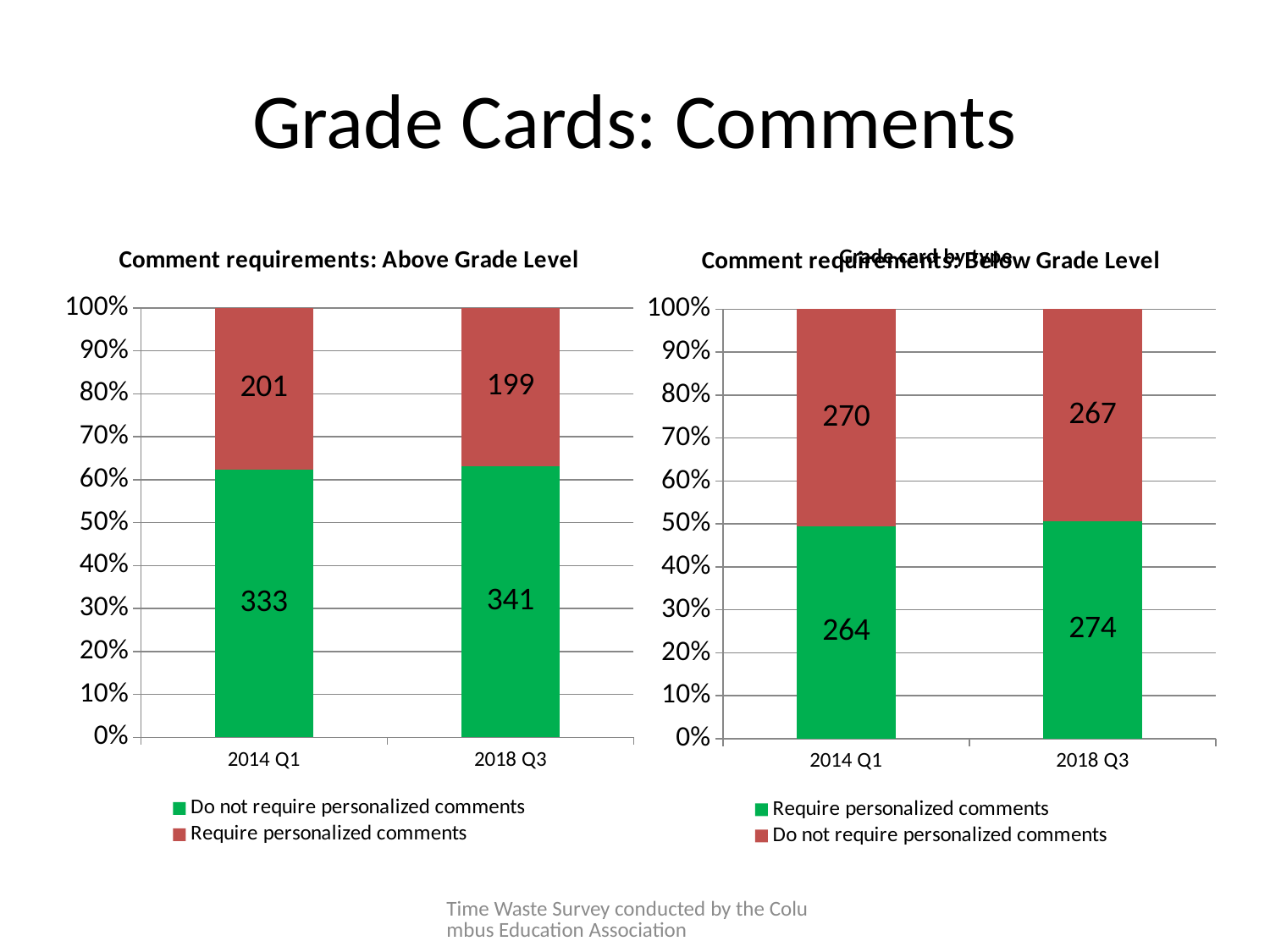
In the 'Comment requirements: Below Grade Level' chart, what is the difference between 'Do not require personalized comments' and 'Require personalized comments' in 2014 Q1? 6 In the 'Comment requirements: Above Grade Level' chart, what is the total of the 2014 Q1 stacked bar? 534 How many series does the legend of the 'Comment requirements: Below Grade Level' chart list? 2 In the 'Comment requirements: Above Grade Level' chart, what is the difference between the 'Do not require personalized comments' values for 2018 Q3 and 2014 Q1? 8 In the 'Comment requirements: Below Grade Level' chart, what is the total of the 2018 Q3 stacked bar? 541 In the 'Comment requirements: Below Grade Level' chart, what is the value for 'Require personalized comments' in 2014 Q1? 264 In the 'Comment requirements: Above Grade Level' chart, which is larger in 2018 Q3: 'Do not require personalized comments' or 'Require personalized comments'? Do not require personalized comments What kind of chart is the 'Comment requirements: Above Grade Level' chart? Stacked bar chart In the 'Comment requirements: Above Grade Level' chart, what is the value for 'Do not require personalized comments' in 2014 Q1? 333 How many categories are shown on the x axis of the 'Comment requirements: Above Grade Level' chart? 2 In the 'Comment requirements: Below Grade Level' chart, what is the value for 'Do not require personalized comments' in 2018 Q3? 267 In the 'Comment requirements: Above Grade Level' chart, what is the value for 'Require personalized comments' in 2018 Q3? 199